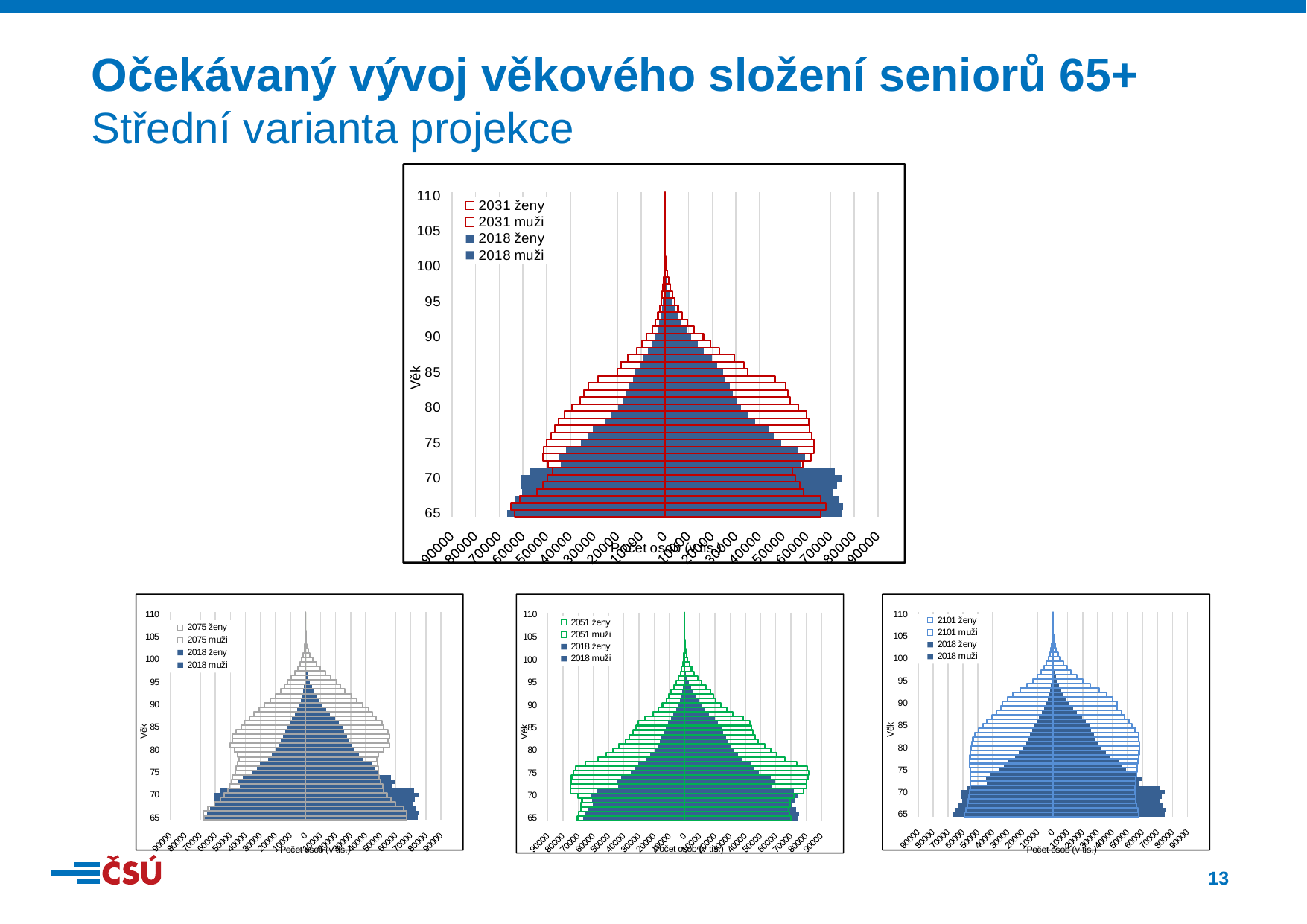
How many series does the legend of the top chart list? 4 How many charts are shown on the slide? 4 In the bottom-right chart, is the value for 2101 ženy at age 80 greater or less than 20000? greater In the bottom-middle chart, which projection year is compared with 2018? 2051 In the bottom-middle chart, is the value for 2051 ženy at age 75 greater or less than 40000? greater In the top chart, is the value for 2031 muži at age 90 greater or less than 20000? less What kind of chart is the large chart at the top of the slide? bar chart In the top chart, at age 80, which is larger: 2031 ženy or 2018 ženy? 2031 ženy In the top chart, do the 2018 muži values rise or fall as age increases from 65 to 110? fall In the top chart, which year is shown with red outlined bars? 2031